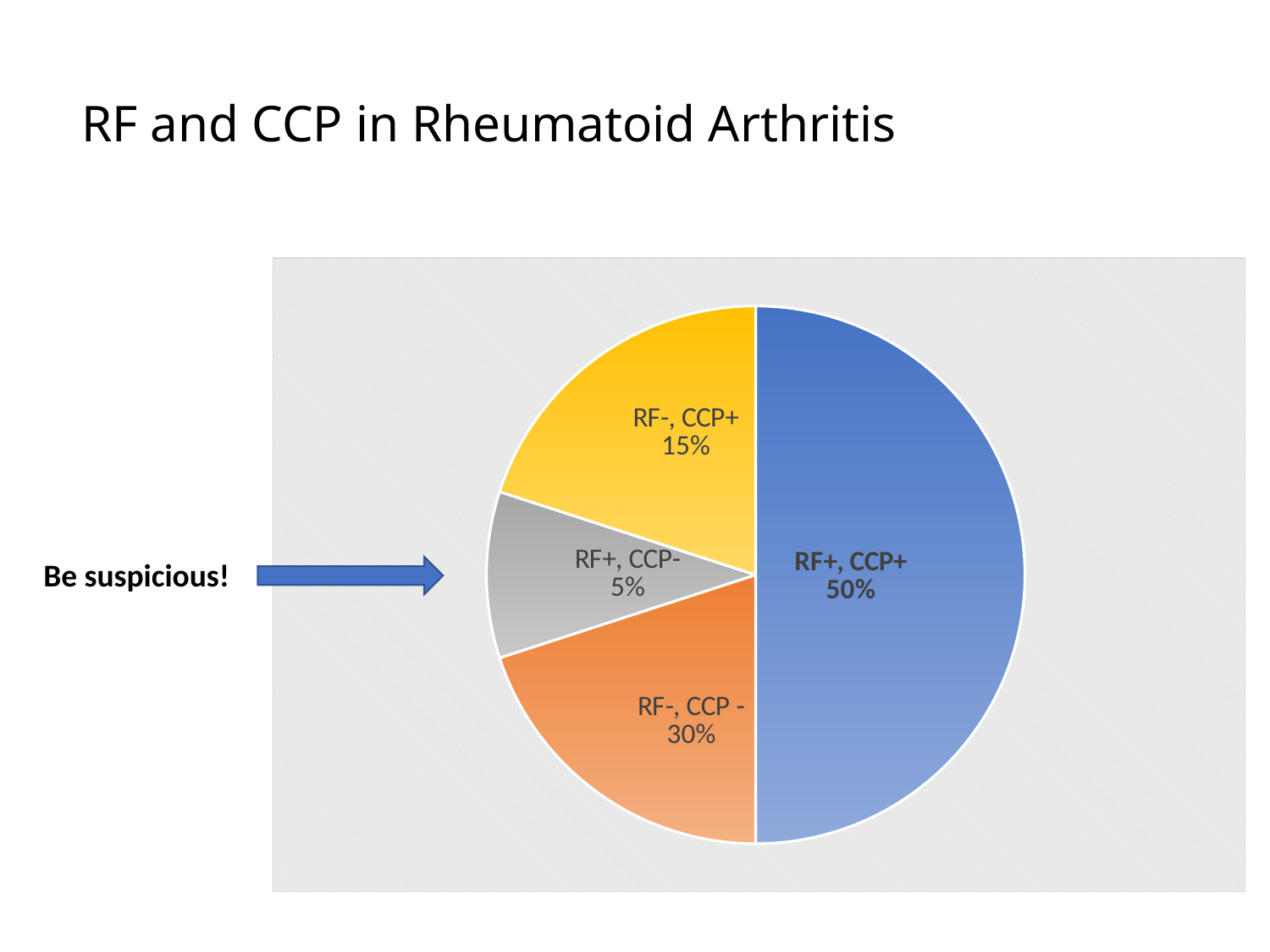
What share of the pie is labelled RF+, CCP-? 5% What is the difference between the RF+, CCP+ share and the RF-, CCP - share? 20% What share of the pie is labelled RF+, CCP+? 50% What kind of chart is shown on the slide? Pie chart What share of the pie is labelled RF-, CCP -? 30% What share of the pie is labelled RF-, CCP+? 15% Which slice of the pie is the largest? RF+, CCP+ How many slices does the pie chart have? 4 Which slice does the arrow labelled 'Be suspicious!' point to? RF+, CCP- Which is larger, the RF-, CCP+ slice or the RF+, CCP- slice? RF-, CCP+ Which slice of the pie is the smallest? RF+, CCP- What is the combined share of the two RF- slices (RF-, CCP+ and RF-, CCP -)? 45%